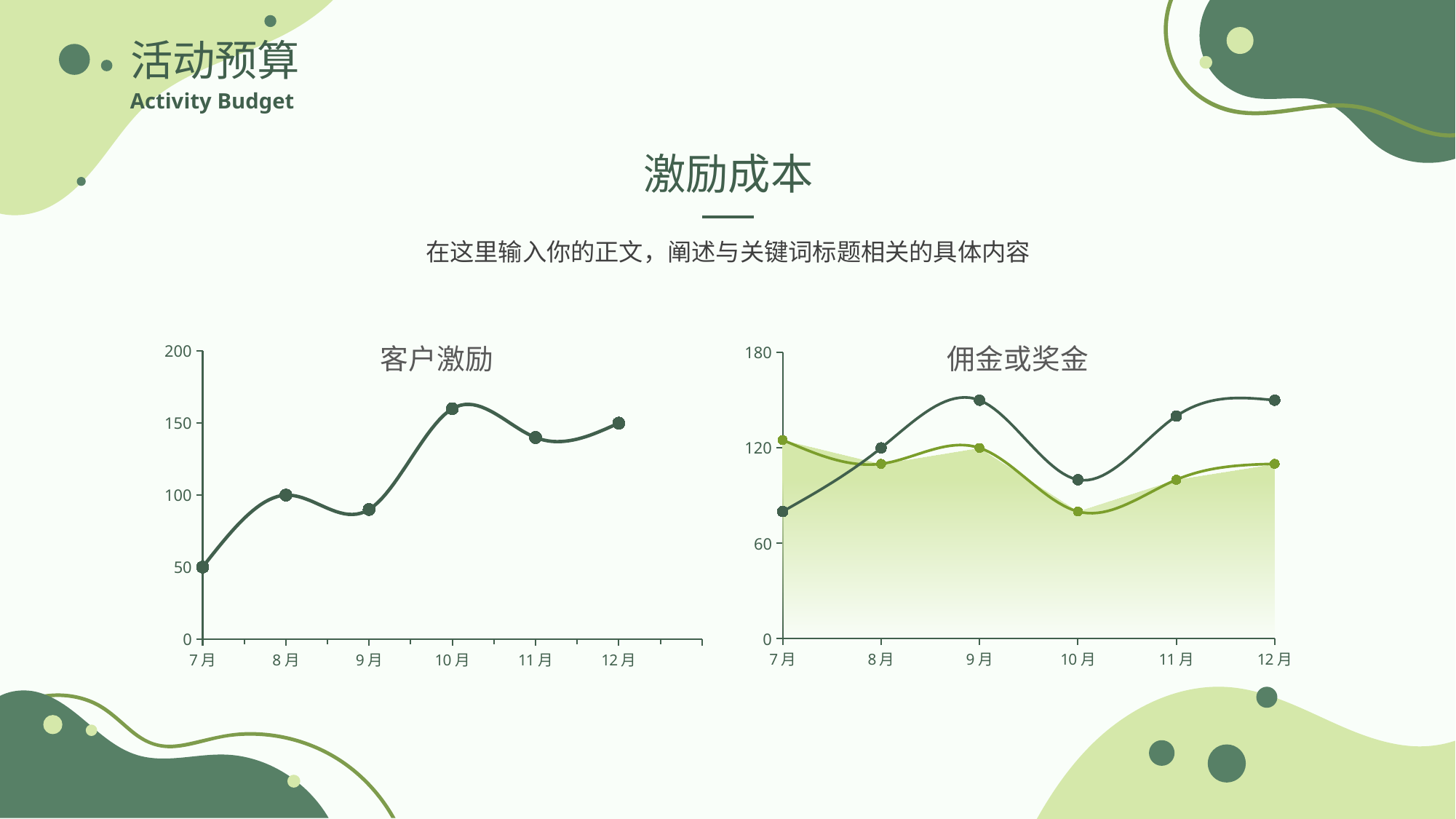
In the 客户激励 chart, what is the value for 8月? 100 In the 客户激励 chart, is the value for 9月 greater or less than 100? less In the 客户激励 chart, what is the difference between the values for 8月 and 7月? 50 In the 佣金或奖金 chart, what is the value of the dark green line for 8月? 120 In the 佣金或奖金 chart, how many data series are plotted? 3 In the 客户激励 chart, what is the value for 12月? 150 In the 客户激励 chart, what is the value for 7月? 50 In the 客户激励 chart, which month has the highest value? 10月 In the 客户激励 chart, how many months are plotted on the x axis? 6 In the 客户激励 chart, which month has the lowest value? 7月 In the 佣金或奖金 chart, is the value of the dark green line for 7月 greater or less than 120? less What type of chart is the 客户激励 chart on the left? line chart